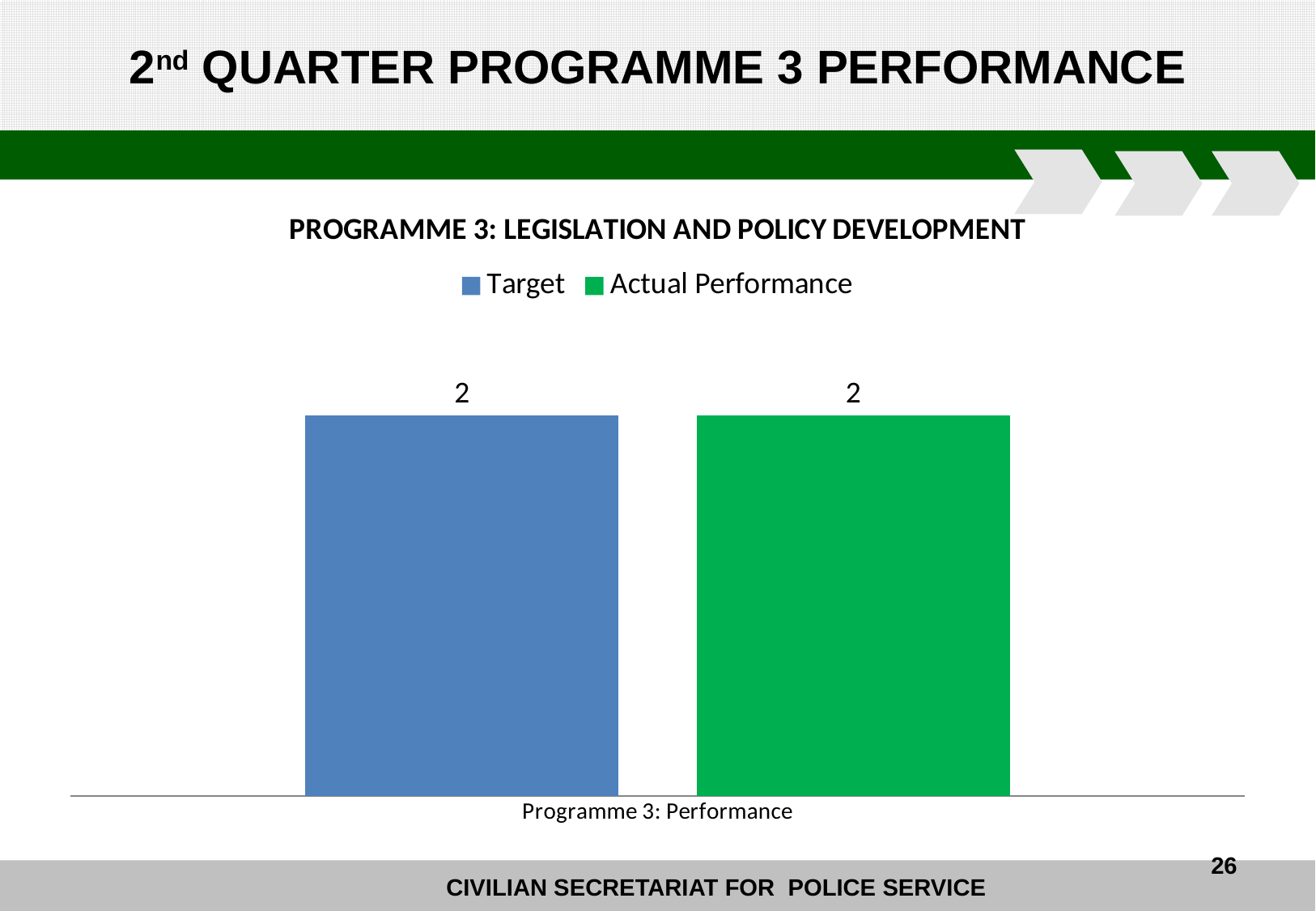
What is the value of the Actual Performance bar for Programme 3: Performance? 2 How many series does the legend list? 2 Which colour represents the Actual Performance series in the chart? Green How many categories are shown on the x axis of the chart? 1 What is the label of the category on the x axis? Programme 3: Performance What kind of chart is shown on the slide? Bar chart What is the difference between the Target and Actual Performance values for Programme 3: Performance? 0 What is the value of the Target bar for Programme 3: Performance? 2 What is the title of the chart? PROGRAMME 3: LEGISLATION AND POLICY DEVELOPMENT